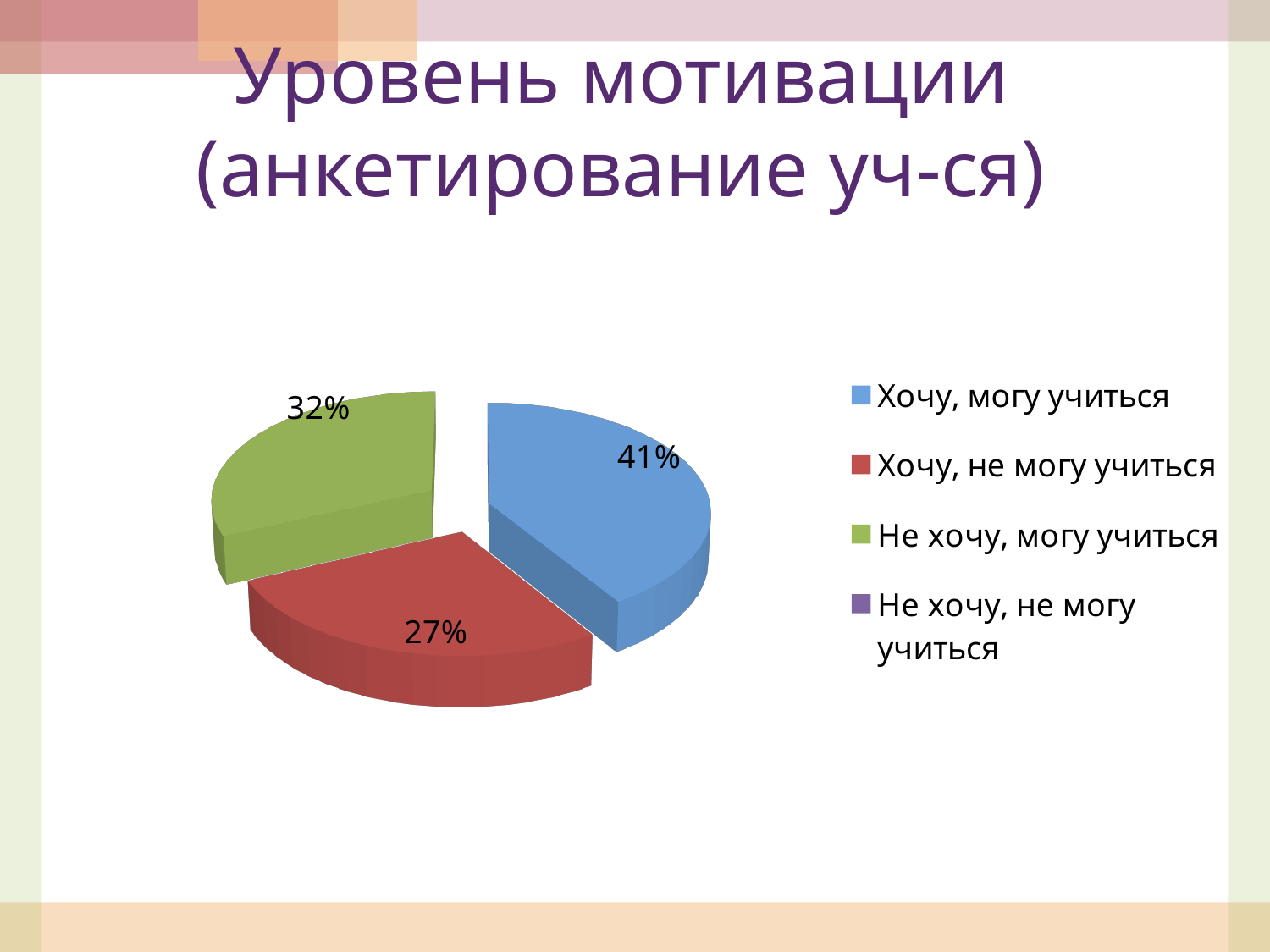
What is the difference in percentage points between "Хочу, могу учиться" and "Хочу, не могу учиться"? 14 What is the title of the slide? Уровень мотивации (анкетирование уч-ся) How many entries does the legend list? 4 What percentage is shown for "Хочу, не могу учиться"? 27% Which category has the largest share of the pie? Хочу, могу учиться What colour is the slice for "Хочу, могу учиться"? blue What percentage is shown for "Не хочу, могу учиться"? 32% Which of the labelled slices has the smallest share of the pie? Хочу, не могу учиться What type of chart is shown on the slide? pie chart What percentage is shown for "Хочу, могу учиться"? 41% How many slices with data labels are visible in the pie? 3 Which is larger: the share for "Не хочу, могу учиться" or the share for "Хочу, не могу учиться"? Не хочу, могу учиться